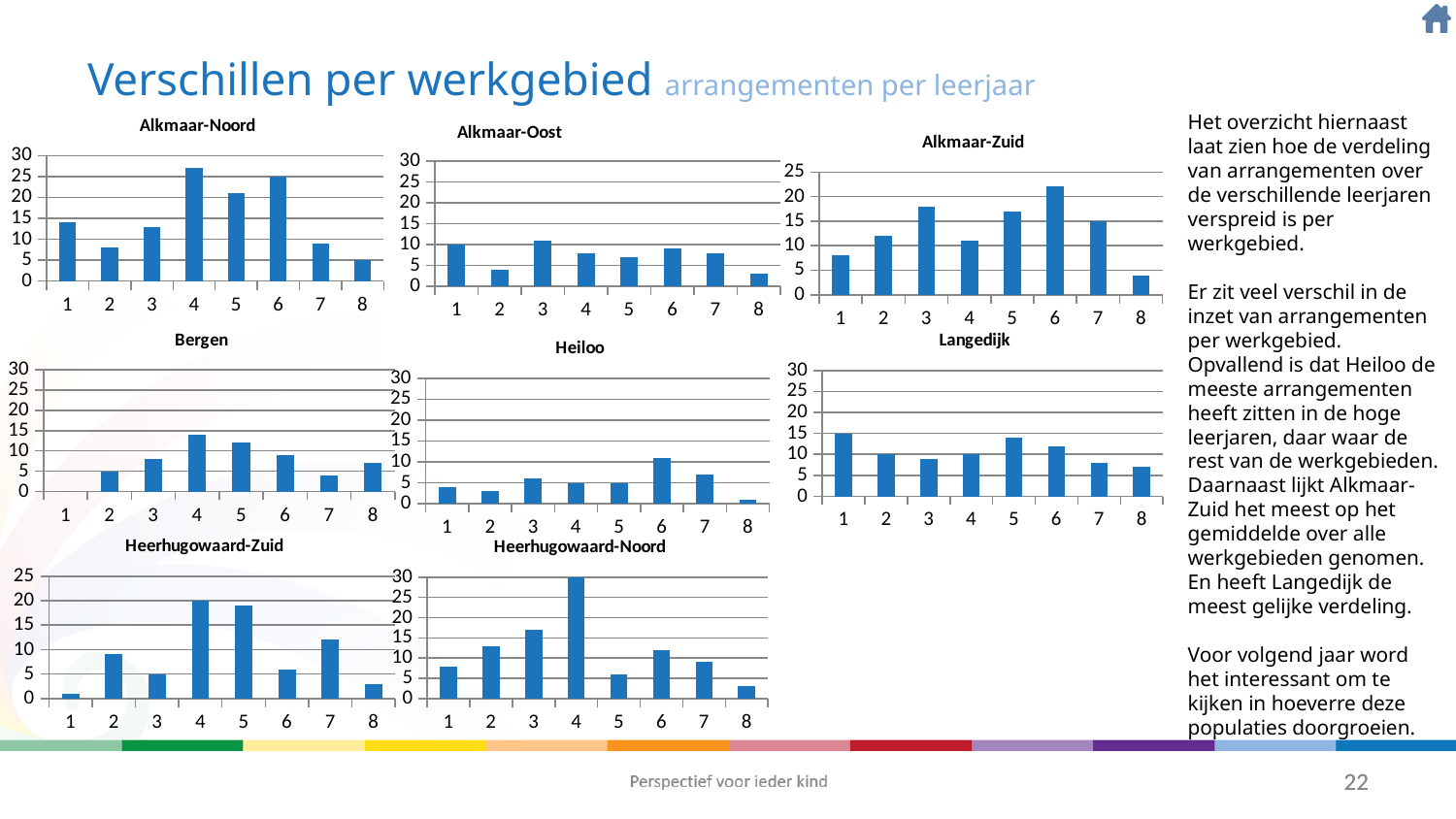
In the Heerhugowaard-Noord chart, which leerjaar has the lowest value? 8 In the Alkmaar-Noord chart, is the value for leerjaar 4 greater or less than 25? greater What kind of chart is the Bergen chart? bar chart In the Alkmaar-Noord chart, which is larger, the value for leerjaar 4 or leerjaar 2? 4 How many leerjaar categories are shown on the x axis of the Langedijk chart? 8 In the Alkmaar-Zuid chart, which leerjaar has the highest value? 6 In the Alkmaar-Zuid chart, is the value for leerjaar 6 greater or less than 20? greater How many charts are shown on the slide? 8 In the Heiloo chart, which leerjaar has the highest value? 6 In the Heerhugowaard-Noord chart, which leerjaar has the highest value? 4 In the Heerhugowaard-Zuid chart, is the value for leerjaar 7 greater or less than 10? greater